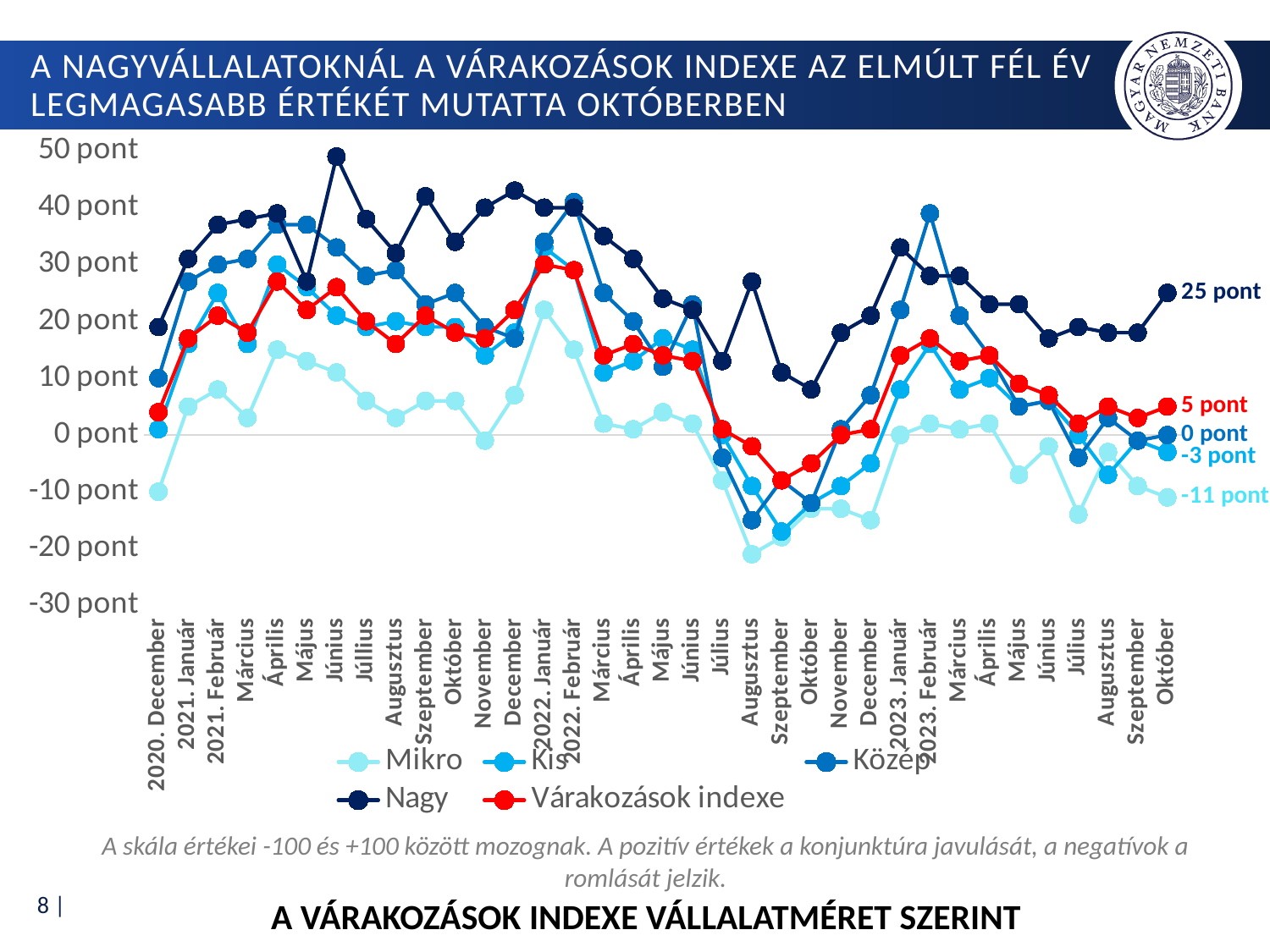
What colour is the line for the Várakozások indexe series? red Is the value of the Mikro series in 2022 Augusztus greater or less than -10 pont? less What is the value of the Mikro series in 2023 Október? -11 pont What is the difference between the Nagy and Várakozások indexe values in 2023 Október? 20 pont Is the value of the Nagy series in 2021 Június greater or less than 40 pont? greater What is the value of the Kis series in 2023 Október? -3 pont What kind of chart is shown on the slide? line chart What is the value of the Nagy series in 2023 Október? 25 pont What is the value of the Várakozások indexe series in 2023 Október? 5 pont What is the value of the Közép series in 2023 Október? 0 pont Which series has the highest value in 2023 Október? Nagy How many series does the legend list? 5